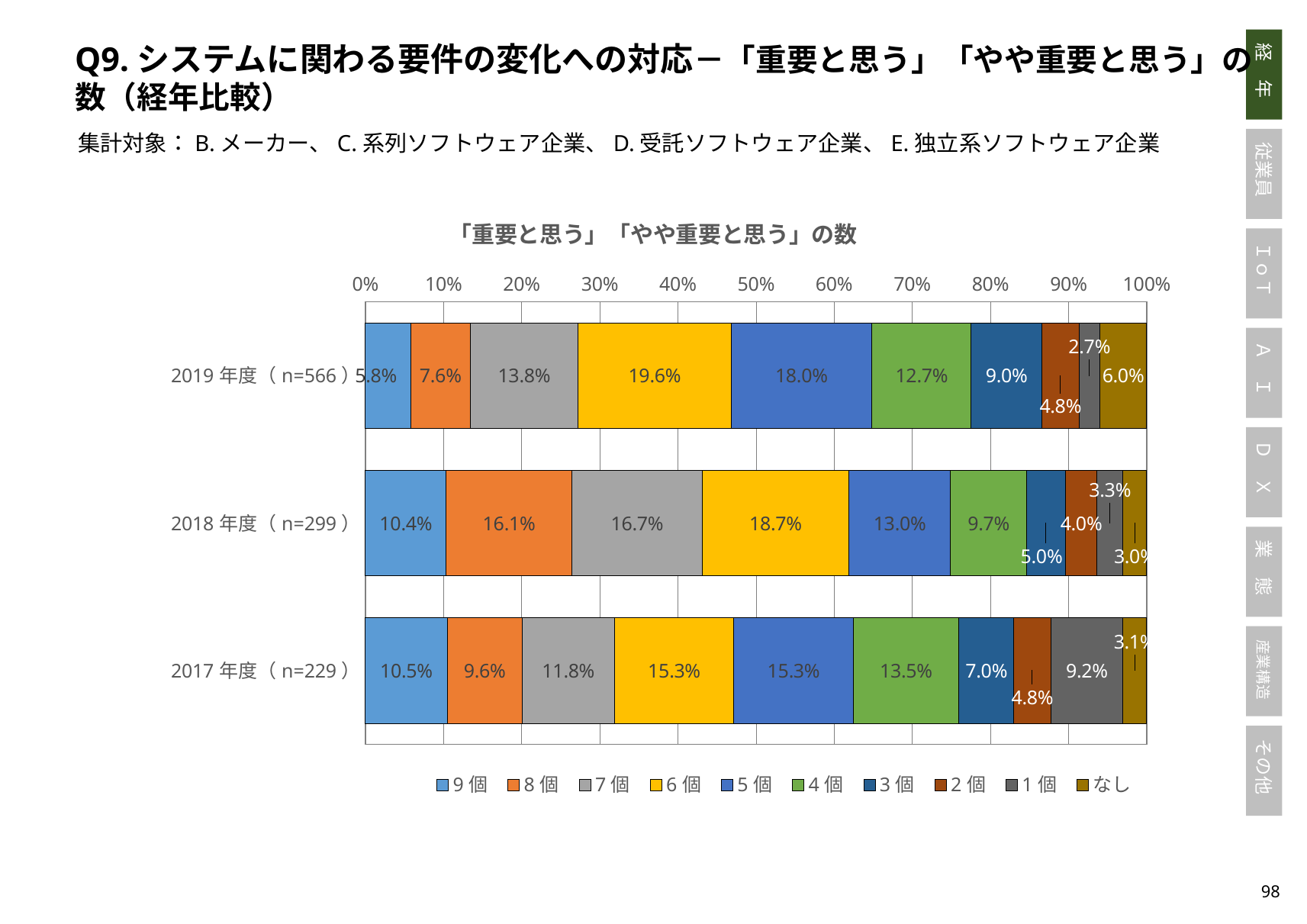
What type of chart is shown on the slide? stacked bar chart What is the sample size (n) shown for 2017年度? 229 What is the value for 1個 in 2017年度? 9.2% How many year categories are plotted on the chart? 3 What is the difference between the 5個 values for 2019年度 and 2018年度? 5.0% Which year has the lowest value for 9個? 2019年度 What is the value for 6個 in 2019年度? 19.6% How many series does the legend list? 10 Which year has the highest value for 8個? 2018年度 What is the value for なし in 2019年度? 6.0% What is the value for 9個 in 2018年度? 10.4% Which is larger: the 7個 value for 2018年度 or for 2017年度? 2018年度